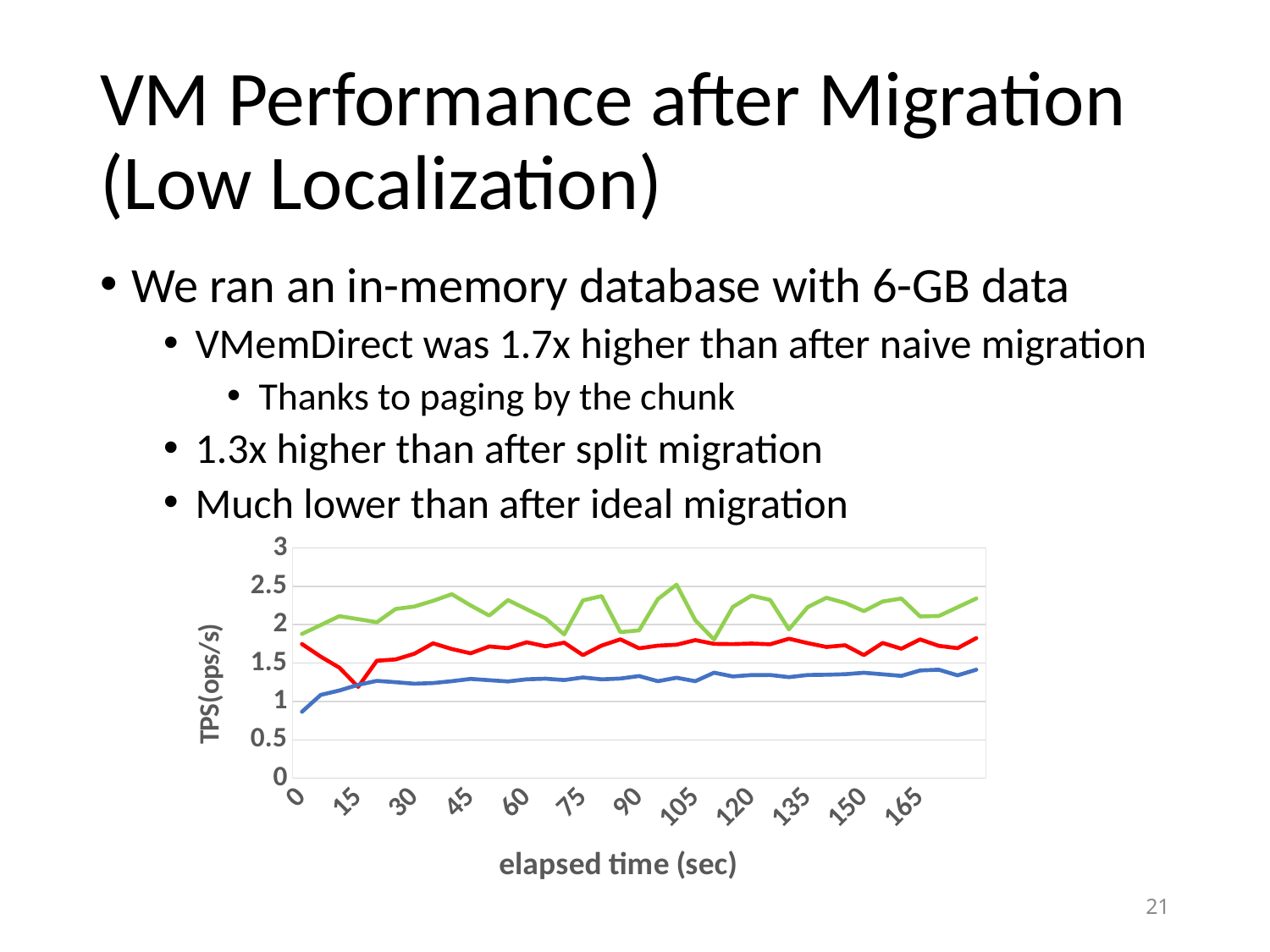
Is the value of the red line at elapsed time 15 greater or less than 1.5? less Is the value of the blue line at elapsed time 0 greater or less than 1? less What is the title of the vertical axis of the chart? TPS(ops/s) What is the title of the horizontal axis of the chart? elapsed time (sec) Is the value of the red line at elapsed time 165 greater or less than 1.5? greater Does the blue line generally rise or fall from elapsed time 0 to 165? rise How many lines are plotted on the chart? 3 At elapsed time 0, which is higher: the green line or the blue line? green line What kind of chart is shown on the slide? line chart Which line is lowest across the chart: the green, red or blue line? blue Which line is highest across the chart: the green, red or blue line? green